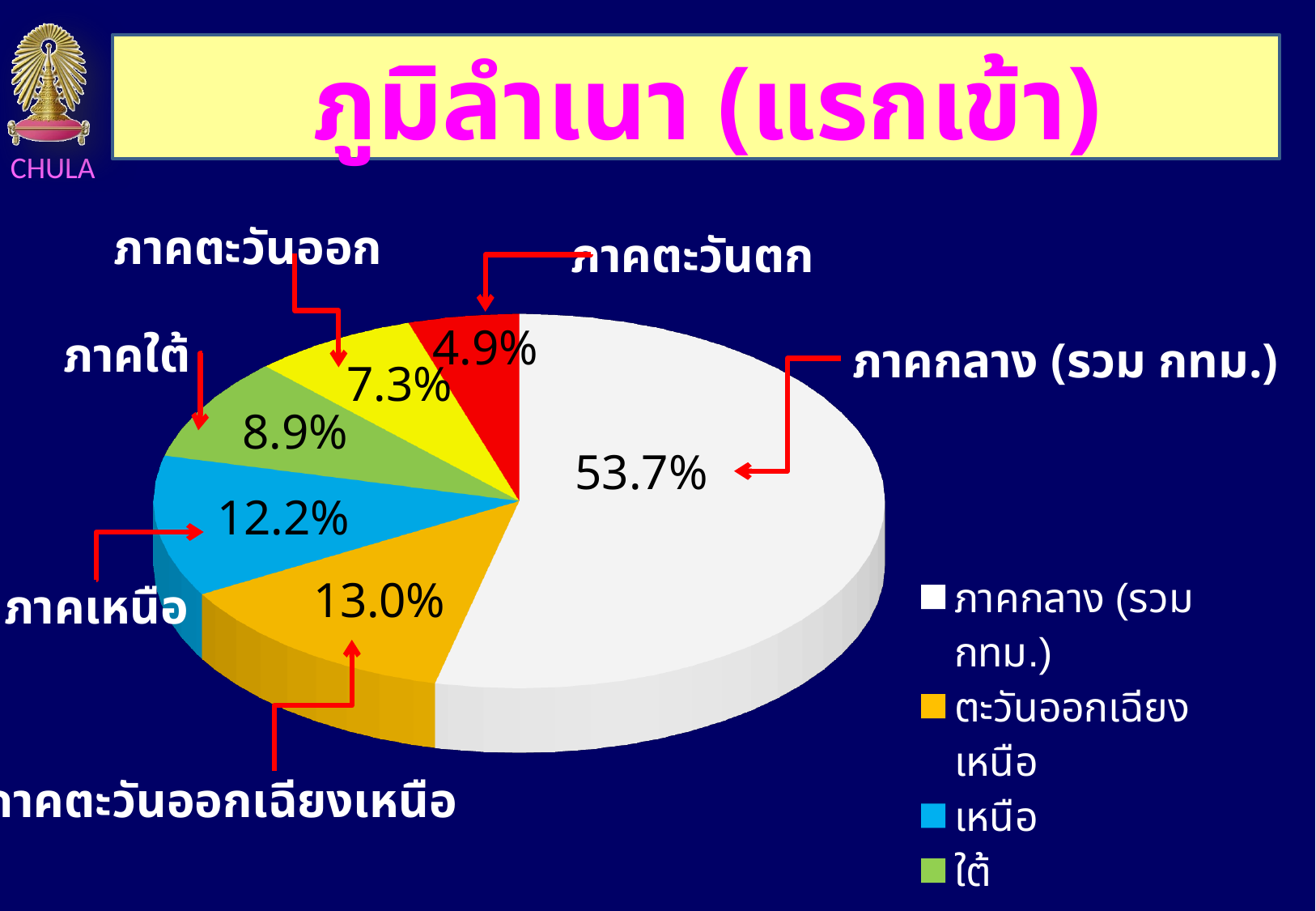
How many slices does the pie chart have? 6 What percentage of the pie is ภาคตะวันออก? 7.3% What percentage of the pie is ภาคใต้? 8.9% What percentage of the pie is ภาคเหนือ? 12.2% What percentage of the pie is ภาคกลาง (รวม กทม.)? 53.7% What percentage of the pie is ภาคตะวันตก? 4.9% What percentage of the pie is ภาคตะวันออกเฉียงเหนือ? 13.0% What is the title of the chart on the slide? ภูมิลำเนา (แรกเข้า) What kind of chart is shown on the slide? pie chart Which region has the largest slice of the pie? ภาคกลาง (รวม กทม.) What is the difference in percentage points between ภาคกลาง (รวม กทม.) and ภาคตะวันออกเฉียงเหนือ? 40.7 Which region has the smallest slice of the pie? ภาคตะวันตก